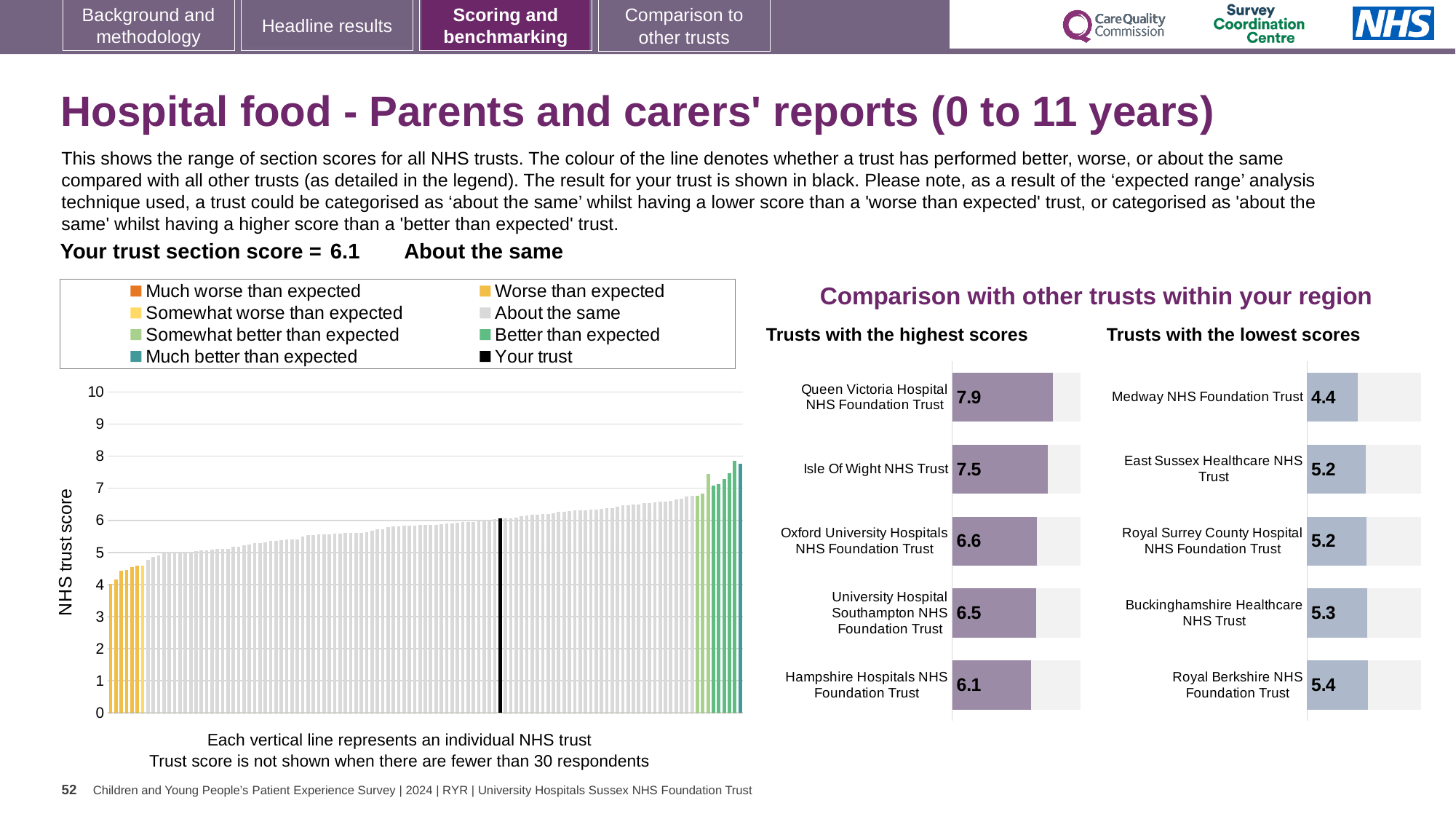
In the 'Trusts with the highest scores' chart, which trust has the highest score? Queen Victoria Hospital NHS Foundation Trust How many trusts are shown in the 'Trusts with the lowest scores' chart? 5 In the 'Trusts with the lowest scores' chart, which trust has the lowest score? Medway NHS Foundation Trust In the 'Trusts with the highest scores' chart, what is the score for Queen Victoria Hospital NHS Foundation Trust? 7.9 In the 'Trusts with the highest scores' chart, which has the higher score: Isle Of Wight NHS Trust or Oxford University Hospitals NHS Foundation Trust? Isle Of Wight NHS Trust In the large chart on the left showing all NHS trusts, what is the section score for your trust (the black bar)? 6.1 In the 'Trusts with the lowest scores' chart, what is the score for Medway NHS Foundation Trust? 4.4 In the 'Trusts with the lowest scores' chart, what is the score for Royal Berkshire NHS Foundation Trust? 5.4 In the 'Trusts with the highest scores' chart, what is the score for Hampshire Hospitals NHS Foundation Trust? 6.1 In the large chart on the left showing all NHS trusts, do the bar values rise or fall from left to right? rise In the 'Trusts with the highest scores' chart, what is the difference between the scores of Queen Victoria Hospital NHS Foundation Trust and Hampshire Hospitals NHS Foundation Trust? 1.8 How many entries does the legend of the large chart on the left list? 8